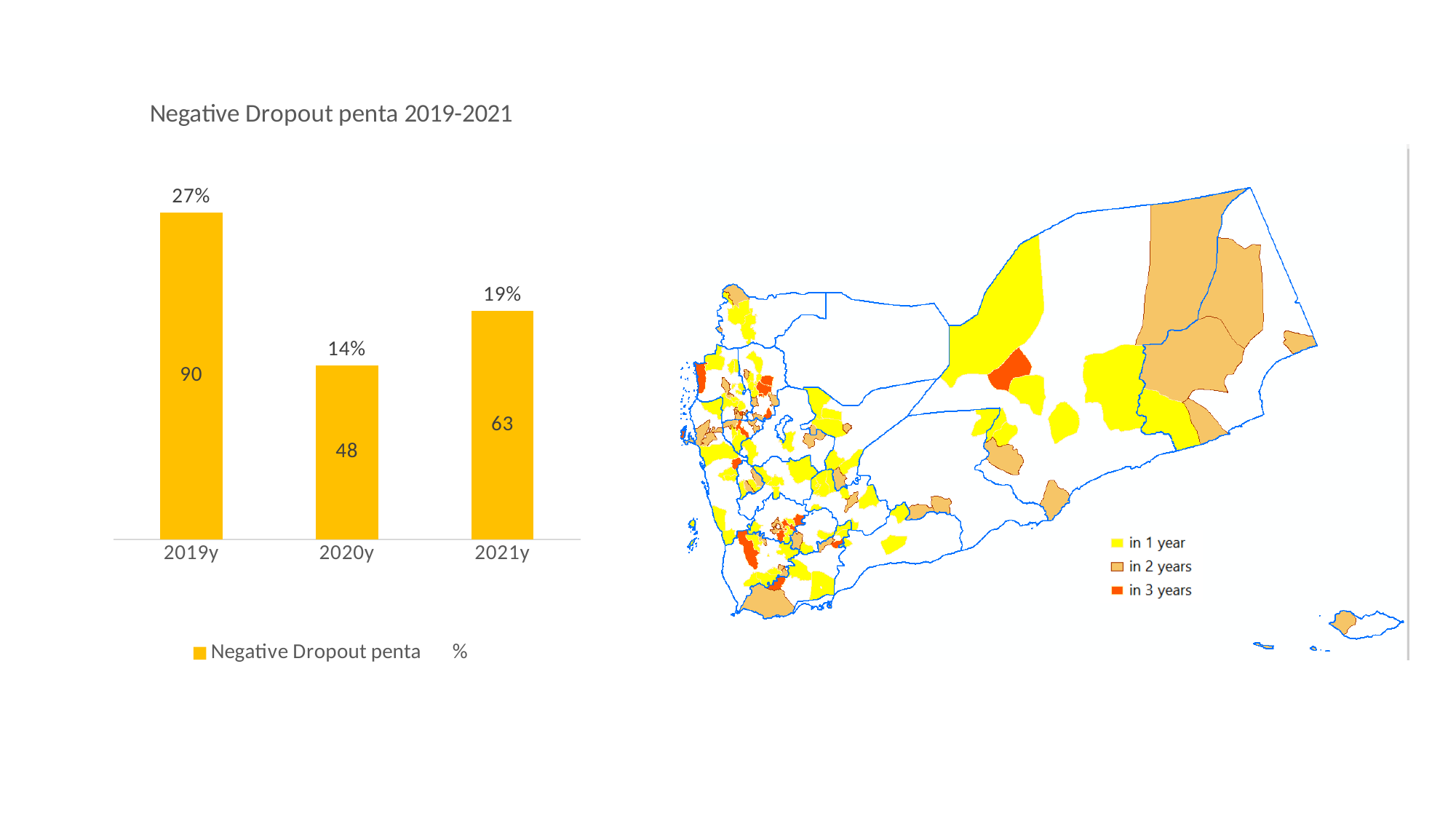
In the bar chart 'Negative Dropout penta 2019-2021', which year has the highest bar? 2019y In the bar chart 'Negative Dropout penta 2019-2021', what is the value labelled inside the bar for 2021y? 63 In the bar chart 'Negative Dropout penta 2019-2021', what percentage is shown above the bar for 2020y? 14% How many years are shown on the x axis of the bar chart 'Negative Dropout penta 2019-2021'? 3 In the bar chart 'Negative Dropout penta 2019-2021', what is the difference between the values for 2019y and 2020y? 42 In the bar chart 'Negative Dropout penta 2019-2021', what is the difference between the values for 2021y and 2020y? 15 In the bar chart 'Negative Dropout penta 2019-2021', which is larger, the value for 2020y or the value for 2021y? 2021y How many categories does the legend of the map on the right of the slide list? 3 What kind of chart is 'Negative Dropout penta 2019-2021'? bar chart In the bar chart 'Negative Dropout penta 2019-2021', what percentage is shown above the bar for 2019y? 27% In the bar chart 'Negative Dropout penta 2019-2021', what is the value labelled inside the bar for 2019y? 90 In the bar chart 'Negative Dropout penta 2019-2021', which year has the lowest bar? 2020y